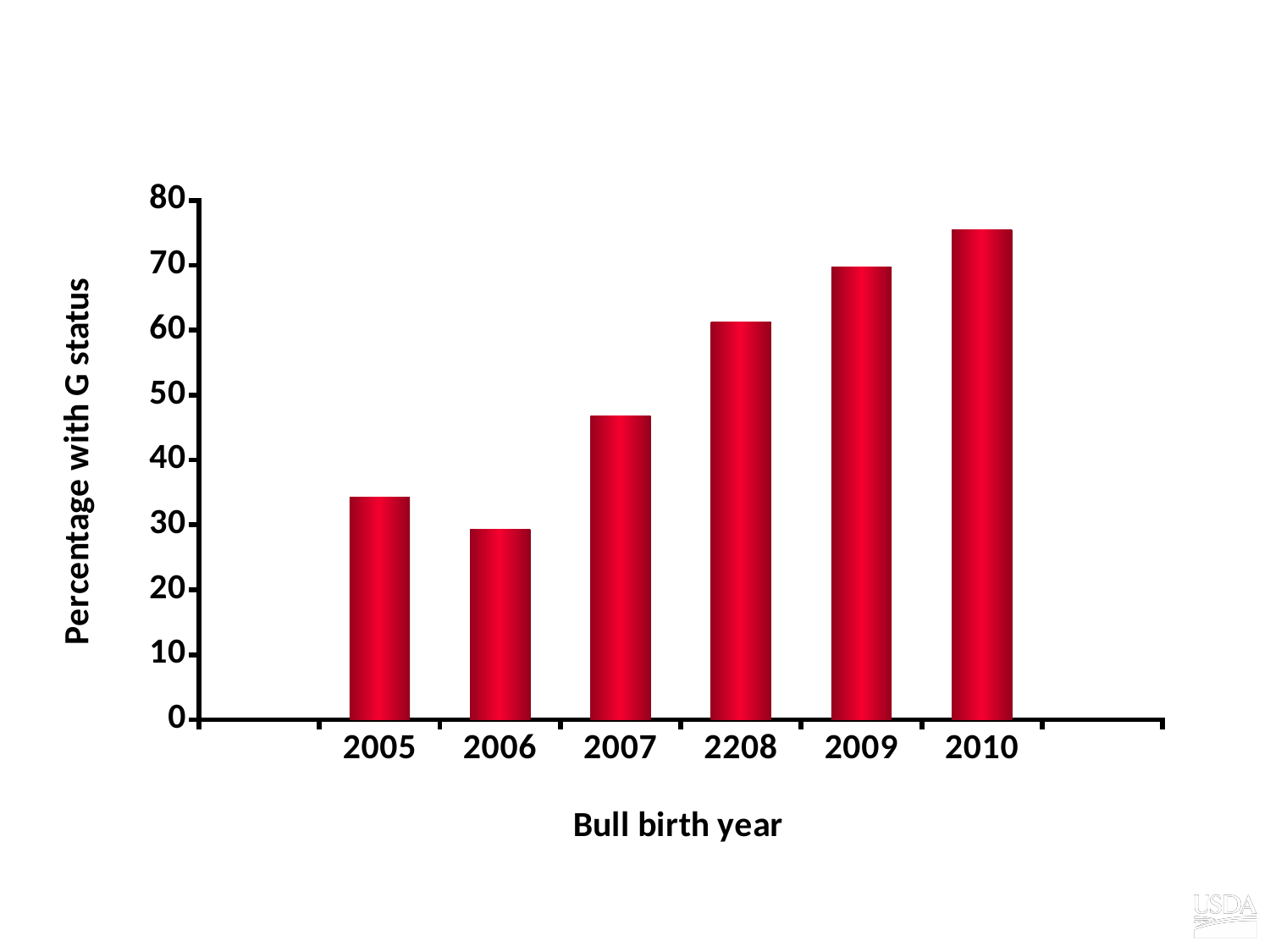
Is the percentage with G status for 2007 greater or less than 50? less Which bull birth year has the lowest percentage with G status? 2006 Is the percentage with G status for 2010 greater or less than 70? greater Which bull birth year has the highest percentage with G status? 2010 Is the percentage with G status for 2009 greater or less than 60? greater What is the label of the y axis? Percentage with G status Which has a higher percentage with G status, 2005 or 2007? 2007 How many bull birth years are plotted on the chart? 6 What kind of chart is shown on the slide? bar chart What is the label of the x axis? Bull birth year